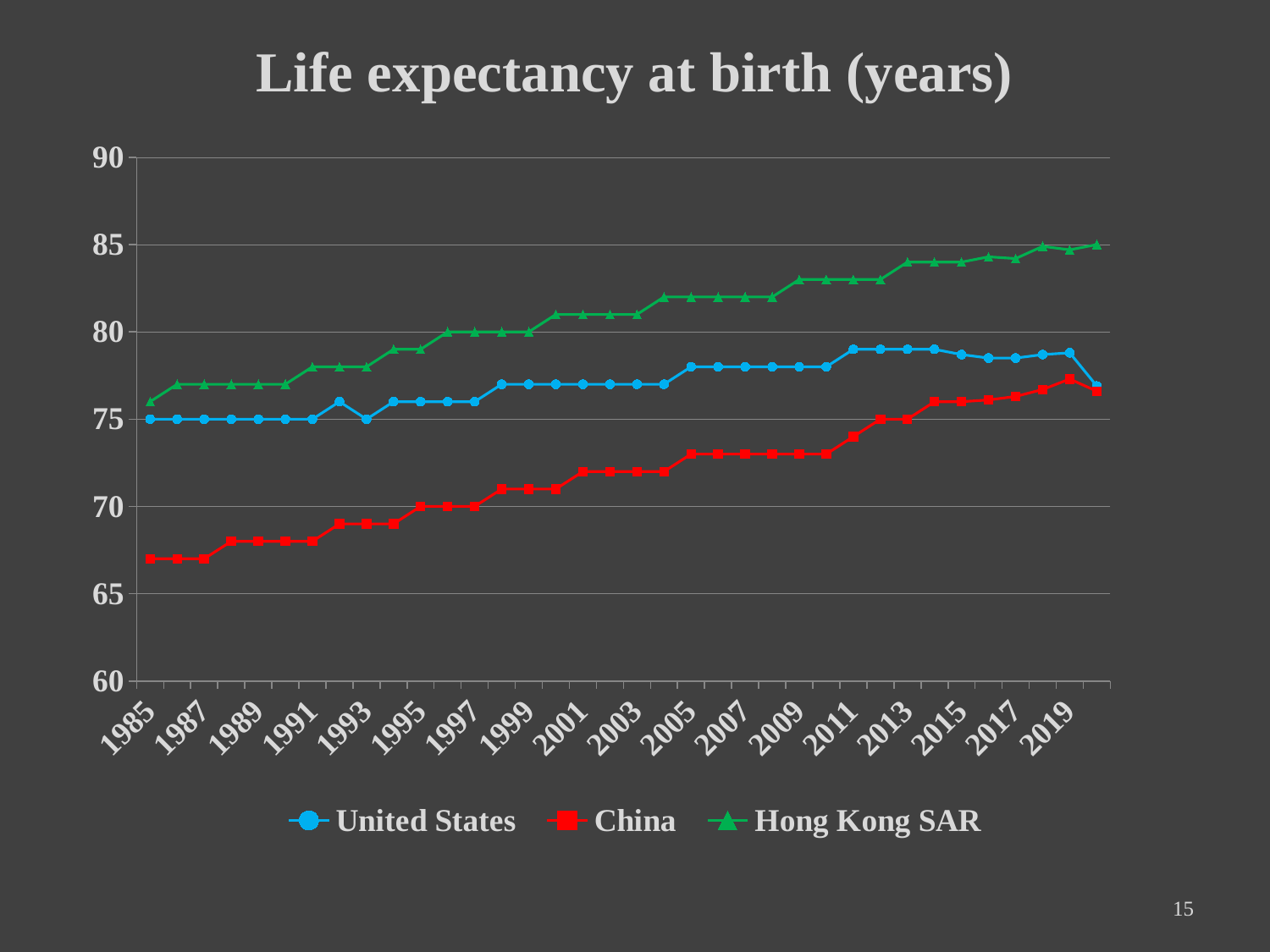
What is the life expectancy for China in 1995? 70 Which series has the highest life expectancy in 2019? Hong Kong SAR What is the life expectancy for Hong Kong SAR in 1997? 80 Which series has the lowest life expectancy in 1985? China How many series does the legend list? 3 Is the value for China in 1985 greater or less than 70? less Is the value for Hong Kong SAR in 2019 greater or less than 80? greater What kind of chart is shown on the slide? line chart Does the life expectancy for China generally rise or fall from 1985 to 2019? rise Which series is represented by the green triangle markers? Hong Kong SAR What is the title of the chart? Life expectancy at birth (years) What is the life expectancy for the United States in 1985? 75